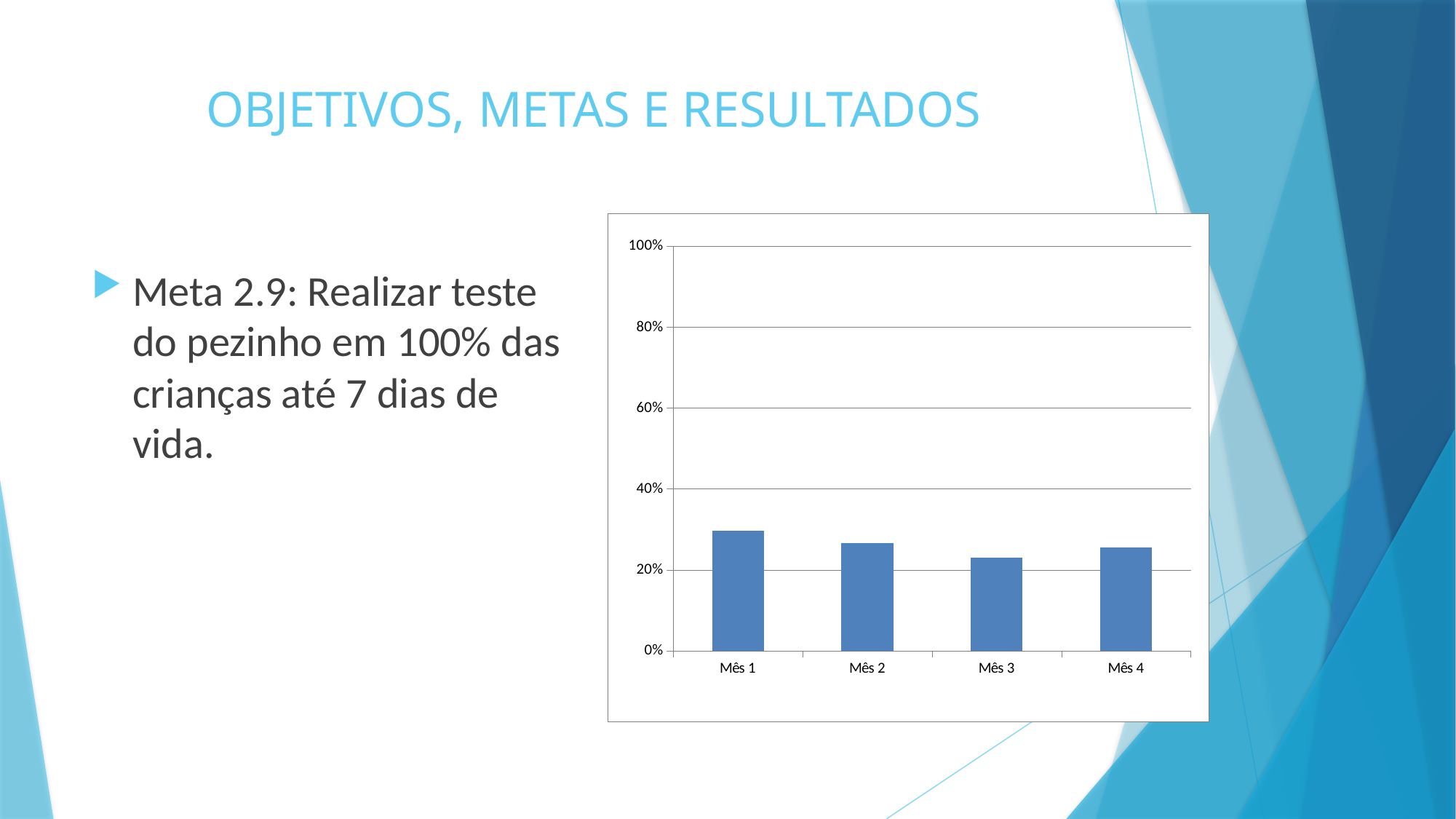
Which month has the lowest bar in the chart? Mês 3 Is the value for Mês 4 greater or less than 20%? greater Which is larger, the value for Mês 1 or the value for Mês 3? Mês 1 Which is larger, the value for Mês 2 or the value for Mês 3? Mês 2 How many categories (months) are shown on the x axis of the chart? 4 Is the value for Mês 3 greater or less than 40%? less Which month has the highest bar in the chart? Mês 1 What kind of chart is shown on the slide? bar chart Is the value for Mês 2 greater or less than 60%? less What is the highest value labelled on the y axis of the chart? 100% Do the values rise or fall from Mês 1 to Mês 3? fall